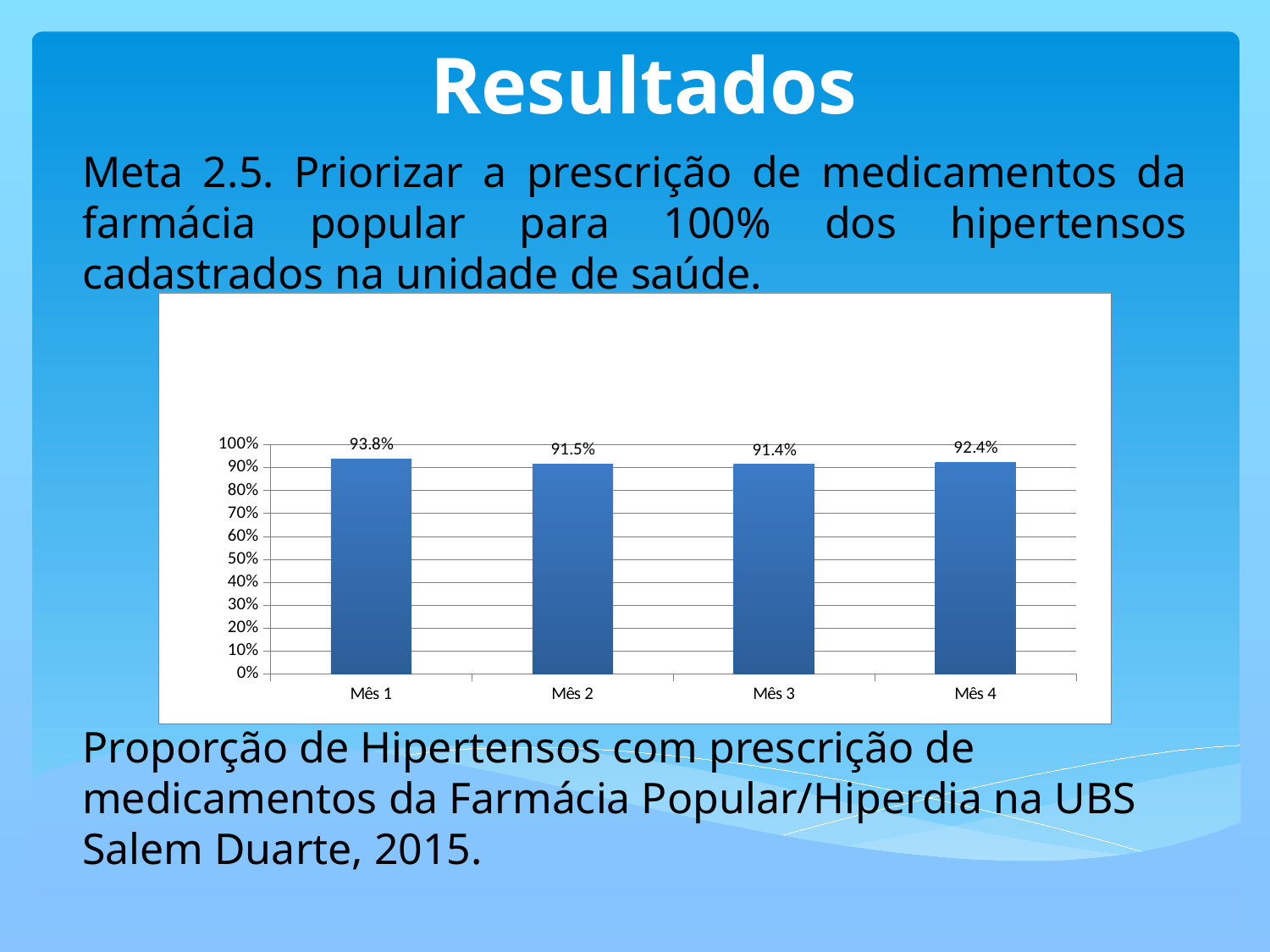
What kind of chart is shown on the slide? bar chart What is the value for Mês 4? 92.4% Is the value for Mês 2 greater or less than 80%? greater Does the value rise or fall from Mês 1 to Mês 2? fall What is the value for Mês 3? 91.4% What is the highest value shown on the y axis? 100% Which is larger, the value for Mês 1 or the value for Mês 4? Mês 1 What is the difference between the values for Mês 1 and Mês 3? 2.4% What is the value for Mês 1? 93.8% Which month has the highest value? Mês 1 How many months are shown on the x axis? 4 What is the difference between the values for Mês 4 and Mês 2? 0.9%